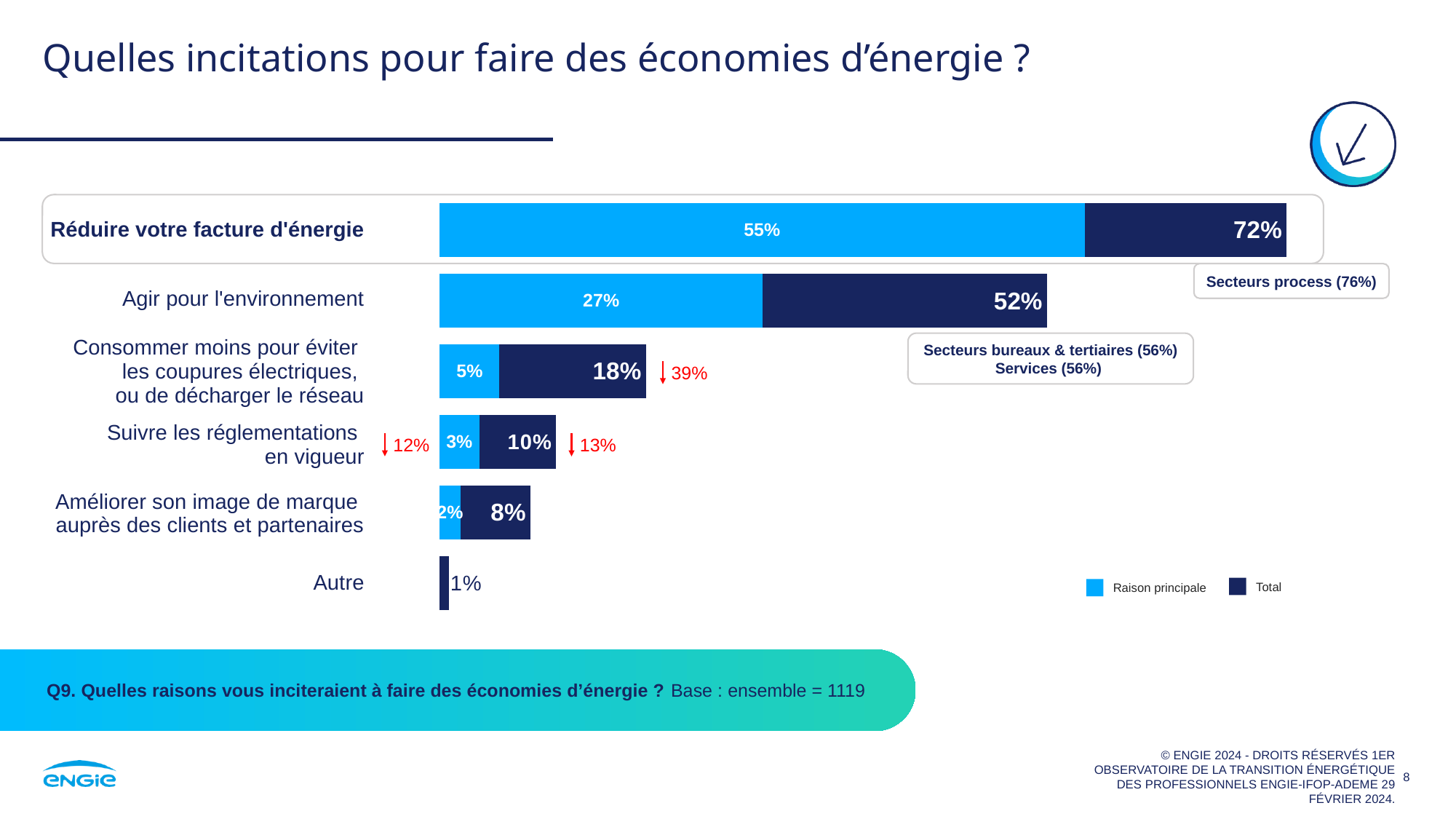
Which category has the lowest Total value? Autre How many series does the legend list? 2 What is the difference between the Total and the "Raison principale" values for "Agir pour l'environnement"? 25% What is the Total value for "Réduire votre facture d'énergie" in the "Secteurs process" callout? 76% Which is larger: the Total value for "Améliorer son image de marque auprès des clients et partenaires" or the Total value for "Suivre les réglementations en vigueur"? Suivre les réglementations en vigueur How many categories are shown in the chart? 6 What kind of chart is shown on the slide? Bar chart What is the "Raison principale" value for "Agir pour l'environnement"? 27% What is the "Raison principale" value for "Consommer moins pour éviter les coupures électriques, ou de décharger le réseau"? 5% What is the Total value for "Réduire votre facture d'énergie"? 72% Which category has the highest Total value? Réduire votre facture d'énergie What is the Total value for "Suivre les réglementations en vigueur"? 10%